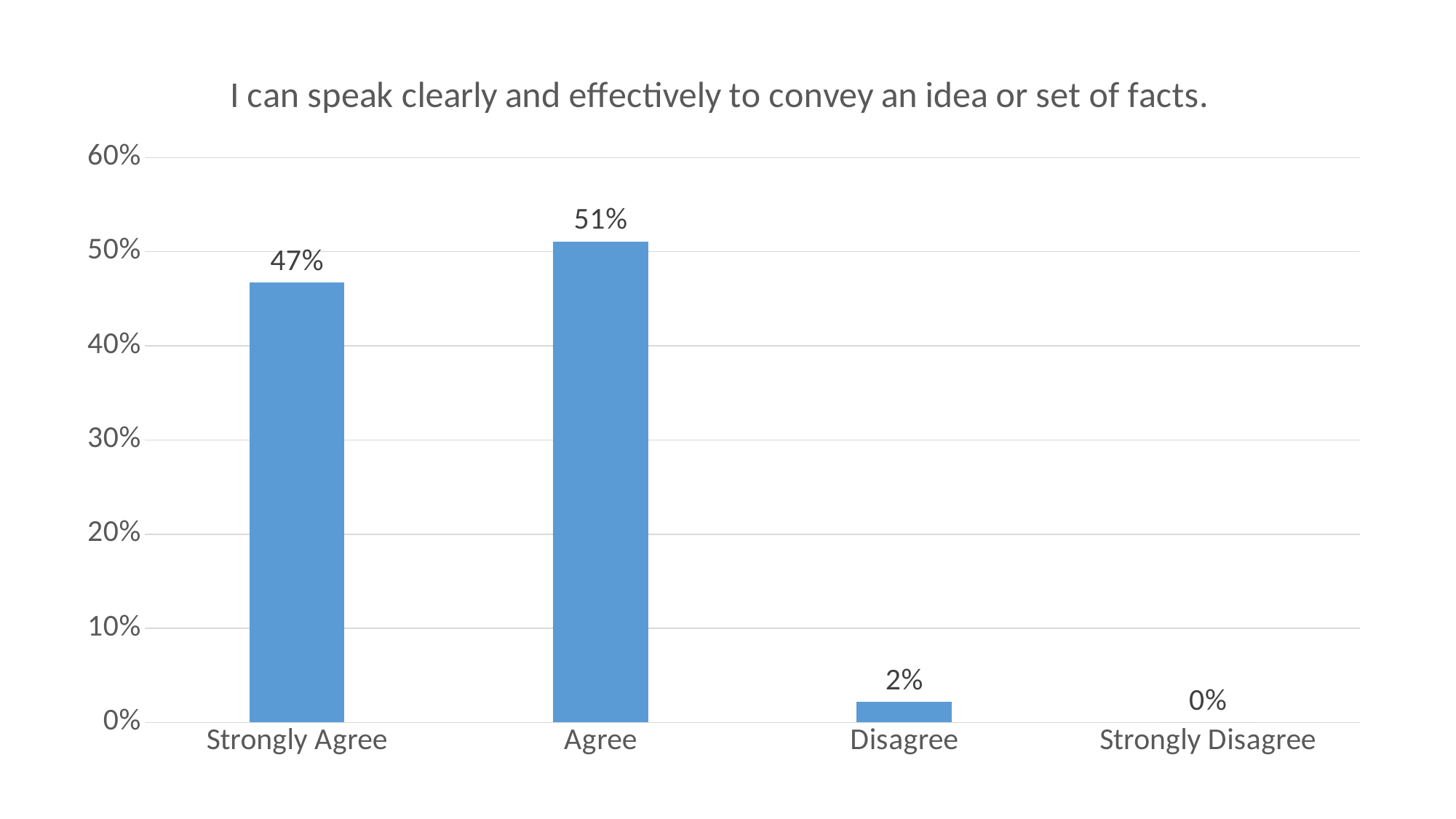
What is the value for Disagree? 2% What is the difference between the values for Agree and Strongly Agree? 4% What kind of chart is shown on the slide? bar chart How many categories are shown on the x axis? 4 What is the title of the chart? I can speak clearly and effectively to convey an idea or set of facts. Which is larger, the value for Strongly Agree or the value for Disagree? Strongly Agree Is the value for Strongly Agree greater or less than 40%? greater What is the value for Strongly Agree? 47% What is the value for Agree? 51% Which category has the highest value? Agree Which category has the lowest value? Strongly Disagree What is the value for Strongly Disagree? 0%